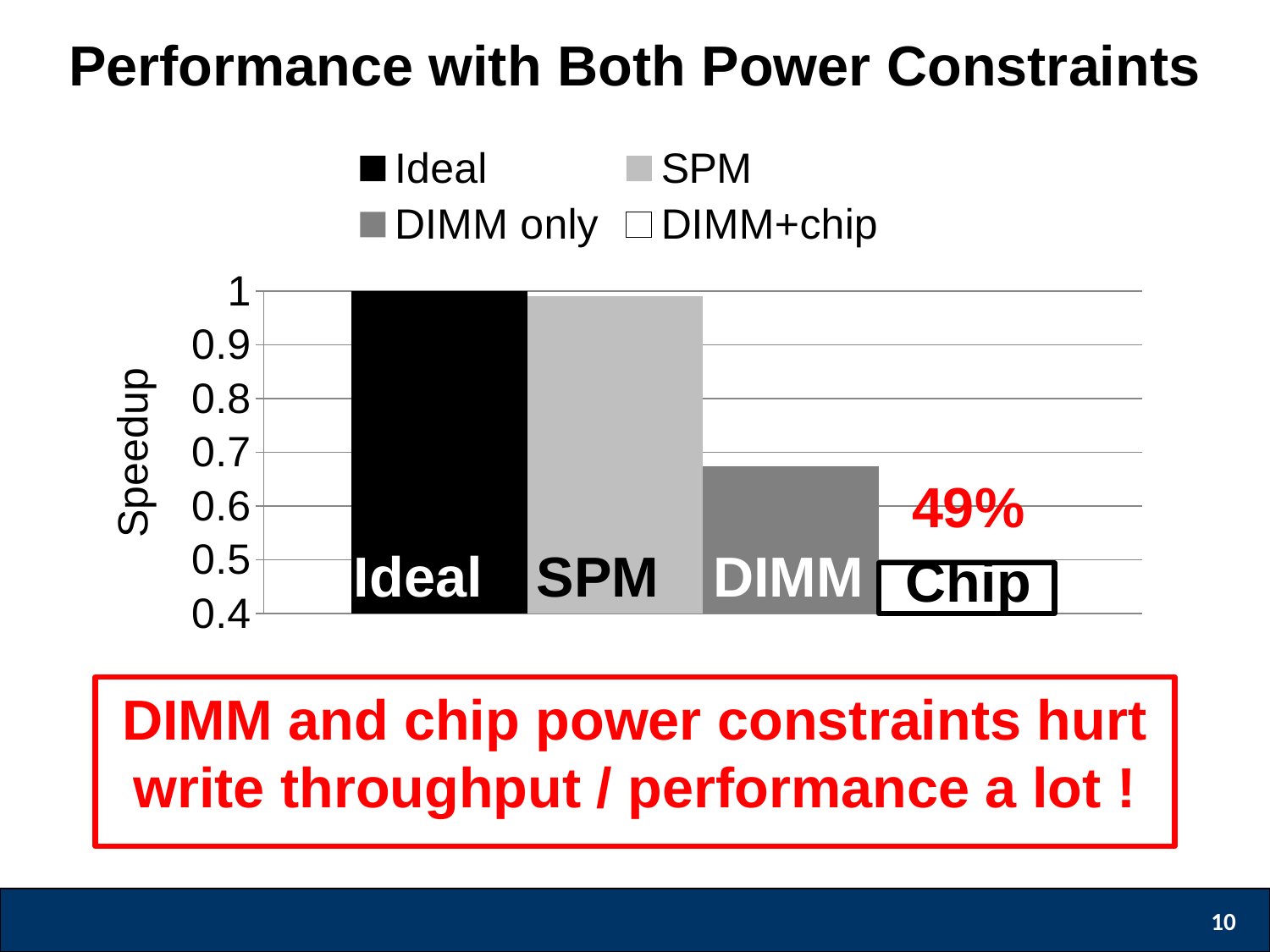
What kind of chart is shown on the slide? bar chart Which is larger, the speedup for SPM or for DIMM only? SPM Which bar has the lowest speedup? DIMM+chip How many bars are plotted in the chart? 4 Do the bar values rise or fall from left to right across the chart? fall How many series does the legend list? 4 Which bar has the highest speedup? Ideal Is the speedup for DIMM only greater or less than 0.6? greater What is the label on the vertical axis of the chart? Speedup What is the speedup value for the Ideal bar? 1 Is the speedup for SPM greater or less than 0.9? greater Which is larger, the speedup for DIMM only or for DIMM+chip? DIMM only